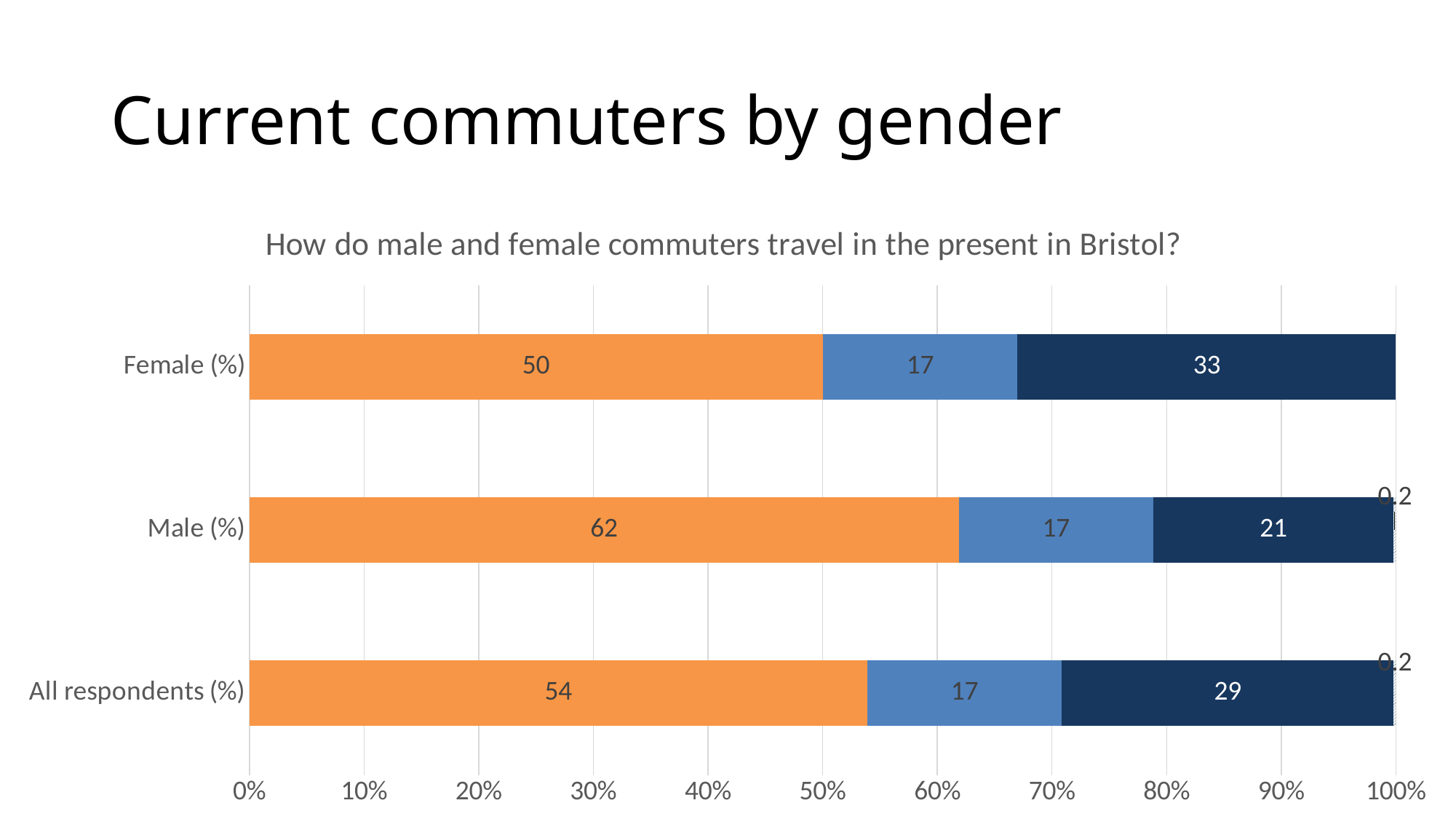
Is the dark blue segment larger for Female (%) or for All respondents (%)? Female (%) How many categories are shown on the vertical axis? 3 What is the value of the orange segment for Male (%)? 62 Which category has the largest orange segment? Male (%) What is the value of the medium blue segment for Male (%)? 17 What is the title of the chart? How do male and female commuters travel in the present in Bristol? What is the value of the dark blue segment for Female (%)? 33 What is the difference between the orange segment values for Male (%) and Female (%)? 12 What is the value of the dark blue segment for All respondents (%)? 29 What is the value of the orange segment for Female (%)? 50 What type of chart is shown on the slide? Stacked bar chart Which category has the smallest dark blue segment? Male (%)